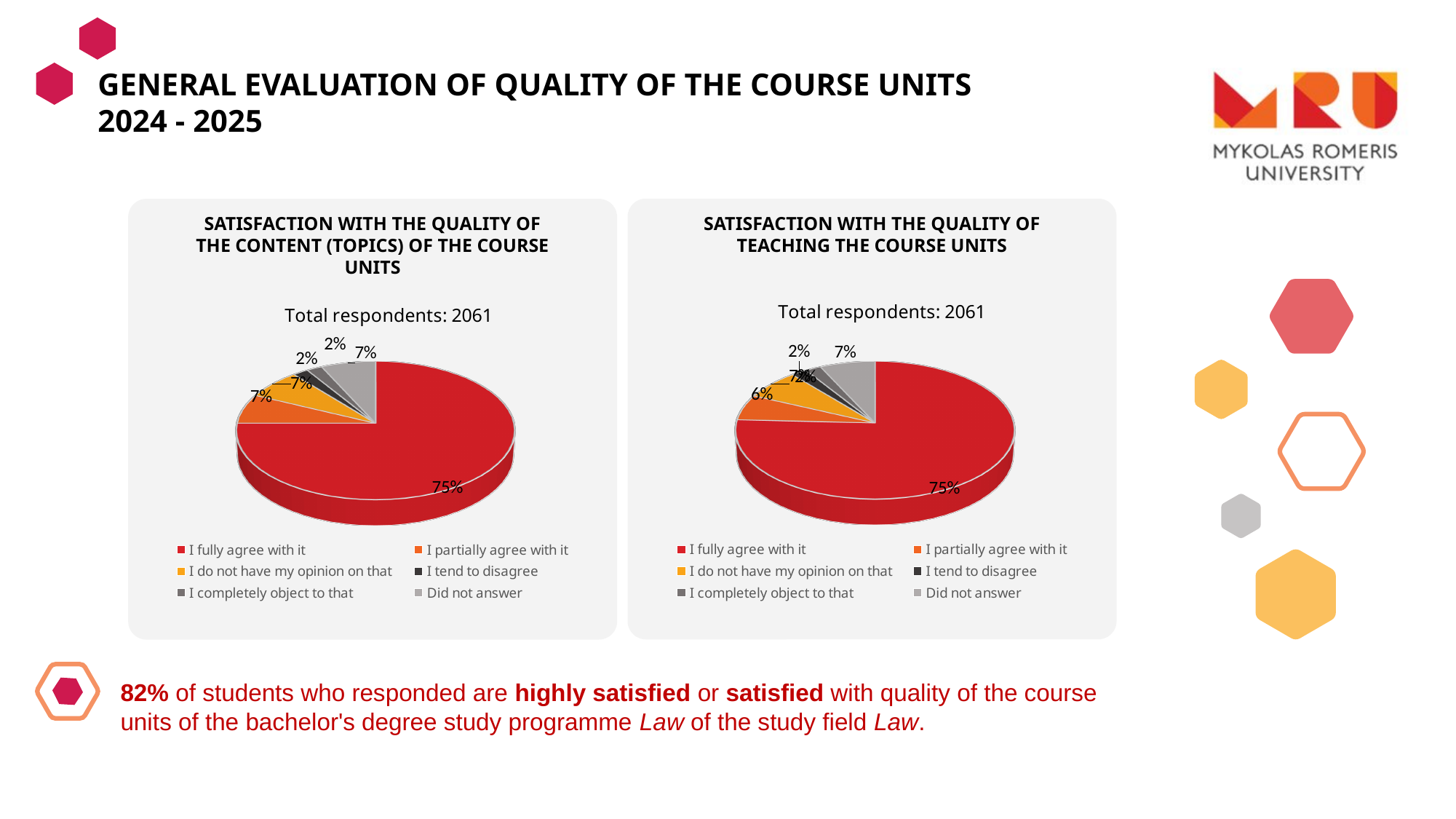
How many categories does the legend of the 'Satisfaction with the quality of teaching the course units' chart list? 6 In the 'Satisfaction with the quality of teaching the course units' chart, what share of respondents chose 'I partially agree with it'? 6% In the 'Satisfaction with the quality of the content (topics) of the course units' chart, what share of respondents chose 'I partially agree with it'? 7% In the 'Satisfaction with the quality of the content (topics) of the course units' chart, what share of respondents chose 'Did not answer'? 7% What kind of chart is used in the 'Satisfaction with the quality of the content (topics) of the course units' chart? Pie chart Which category has the largest slice in the 'Satisfaction with the quality of the content (topics) of the course units' chart? I fully agree with it In the 'Satisfaction with the quality of teaching the course units' chart, which is larger: the share for 'I fully agree with it' or the share for 'I partially agree with it'? I fully agree with it In the 'Satisfaction with the quality of the content (topics) of the course units' chart, what is the difference in percentage points between 'I fully agree with it' and 'I partially agree with it'? 68 percentage points How many total respondents are reported for the 'Satisfaction with the quality of the content (topics) of the course units' chart? 2061